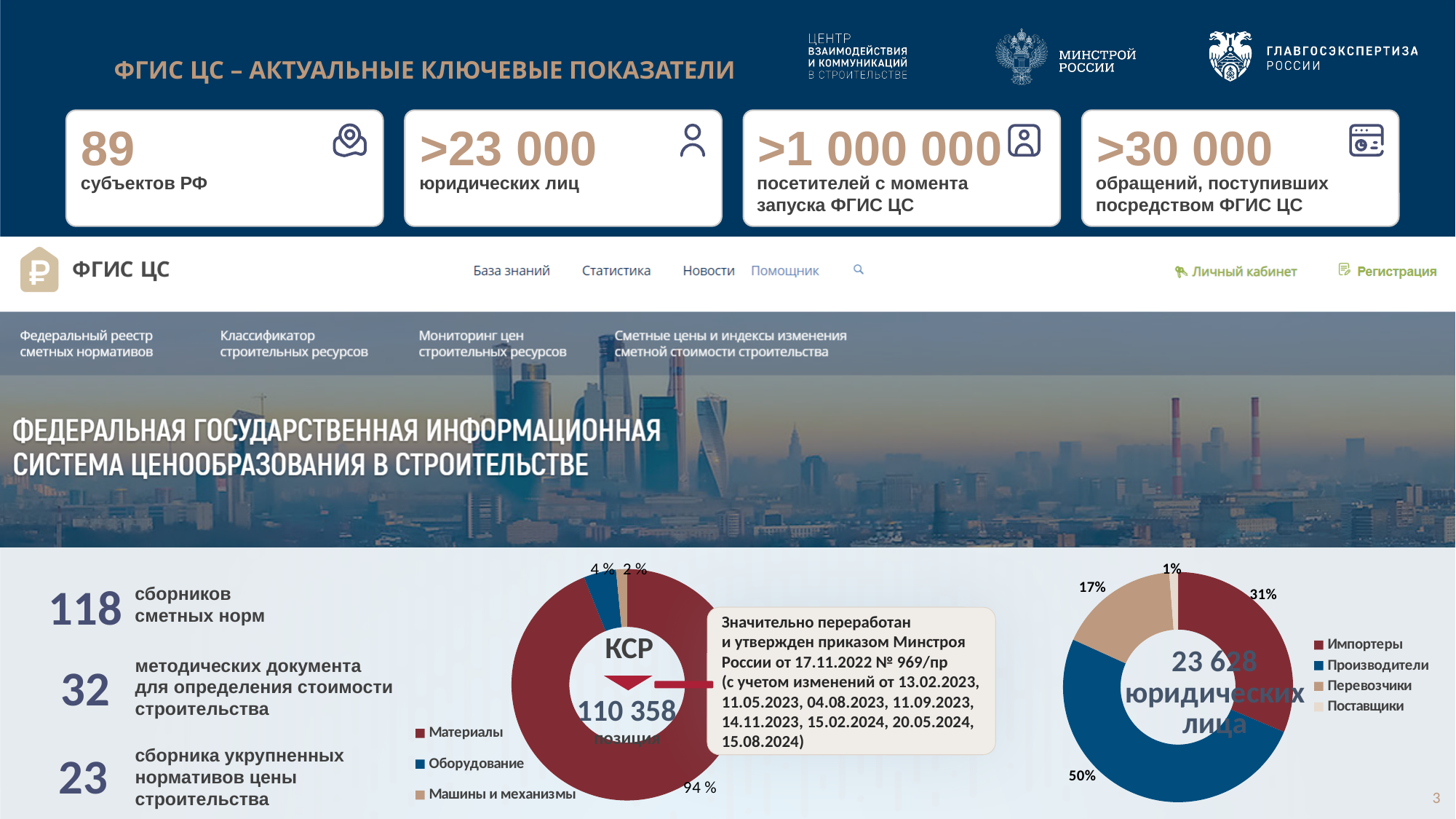
In the КСР donut chart on the left, which category has the smallest share? Машины и механизмы What type of chart is used for the КСР chart on the left? Donut (pie) chart In the donut chart on the right (23 628 юридических лица), what share is shown for Импортеры? 31% In the donut chart on the right (23 628 юридических лица), which category has the smallest share? Поставщики In the donut chart on the right (23 628 юридических лица), what share is shown for Перевозчики? 17% In the donut chart on the right (23 628 юридических лица), what share is shown for Производители? 50% In the КСР donut chart on the left, what share is shown for Машины и механизмы? 2 % In the КСР donut chart on the left, what share is shown for Материалы? 94 % In the КСР donut chart on the left, what share is shown for Оборудование? 4 % In the КСР donut chart on the left, how many categories does the legend list? 3 In the КСР donut chart on the left, which category has the largest share? Материалы In the donut chart on the right (23 628 юридических лица), what is the difference between the shares of Производители and Импортеры? 19%